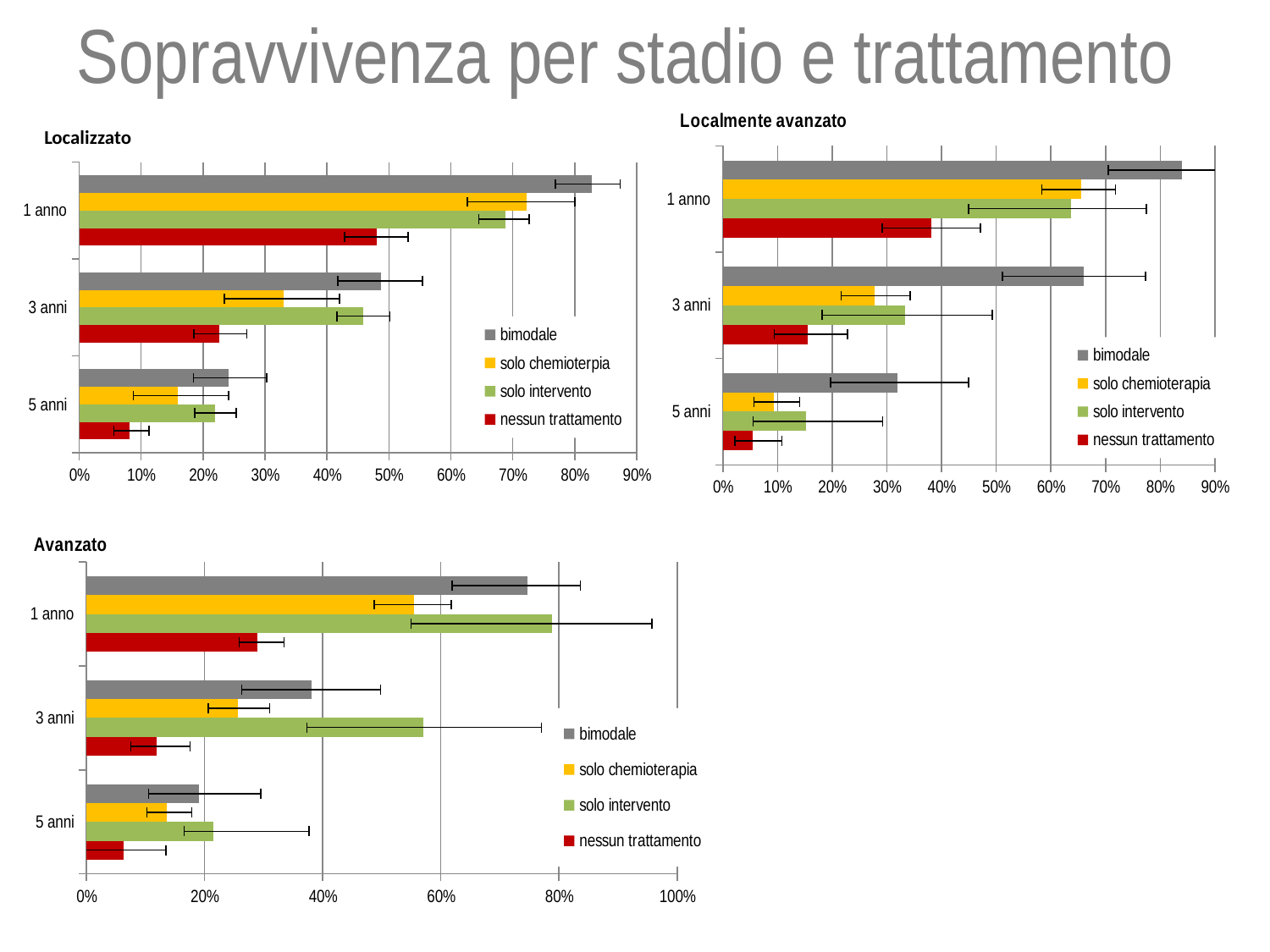
In the 'Localizzato' chart, is the value for bimodale at 1 anno greater or less than 80%? greater What is the maximum value shown on the horizontal axis of the 'Avanzato' chart? 100% In the 'Localizzato' chart, do the bimodale values rise or fall from 1 anno to 5 anni? fall What kind of chart is the 'Localizzato' chart? bar chart In the 'Avanzato' chart, is the value for nessun trattamento at 1 anno greater or less than 40%? less In the 'Localizzato' chart, is the value for nessun trattamento at 5 anni greater or less than 10%? less In the 'Localizzato' chart, how many series does the legend list? 4 In the 'Localmente avanzato' chart, which treatment has the highest value at 1 anno? bimodale In the 'Localmente avanzato' chart, which treatment has the lowest value at 5 anni? nessun trattamento In the 'Avanzato' chart, at 3 anni, which is larger: solo intervento or bimodale? solo intervento In the 'Avanzato' chart, how many time categories are shown on the vertical axis? 3